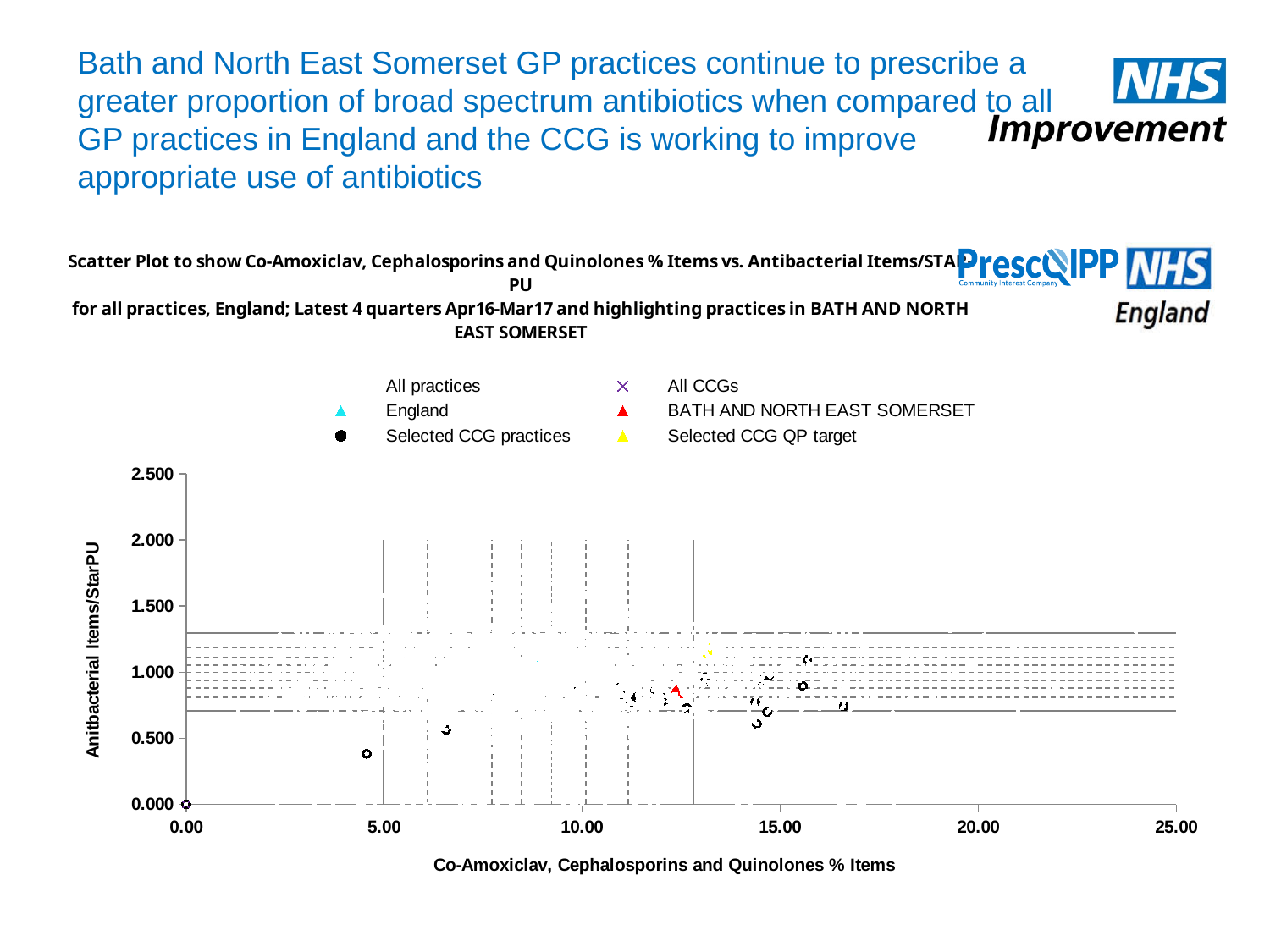
What kind of chart is shown on the slide? Scatter plot What is the highest value shown on the y axis? 2.500 Is the x-axis value for the Selected CCG QP target marker greater or less than 15.00? less Is the x-axis value for the BATH AND NORTH EAST SOMERSET marker greater or less than 10.00? greater How many tick labels are shown on the x axis? 6 Is the y-axis value for the BATH AND NORTH EAST SOMERSET marker greater or less than 0.500? greater What colour is the marker for BATH AND NORTH EAST SOMERSET in the legend? Red What is the label of the x axis of the scatter plot? Co-Amoxiclav, Cephalosporins and Quinolones % Items Which marker is higher on the y axis: the Selected CCG QP target or BATH AND NORTH EAST SOMERSET? Selected CCG QP target How many series does the chart legend list? 6